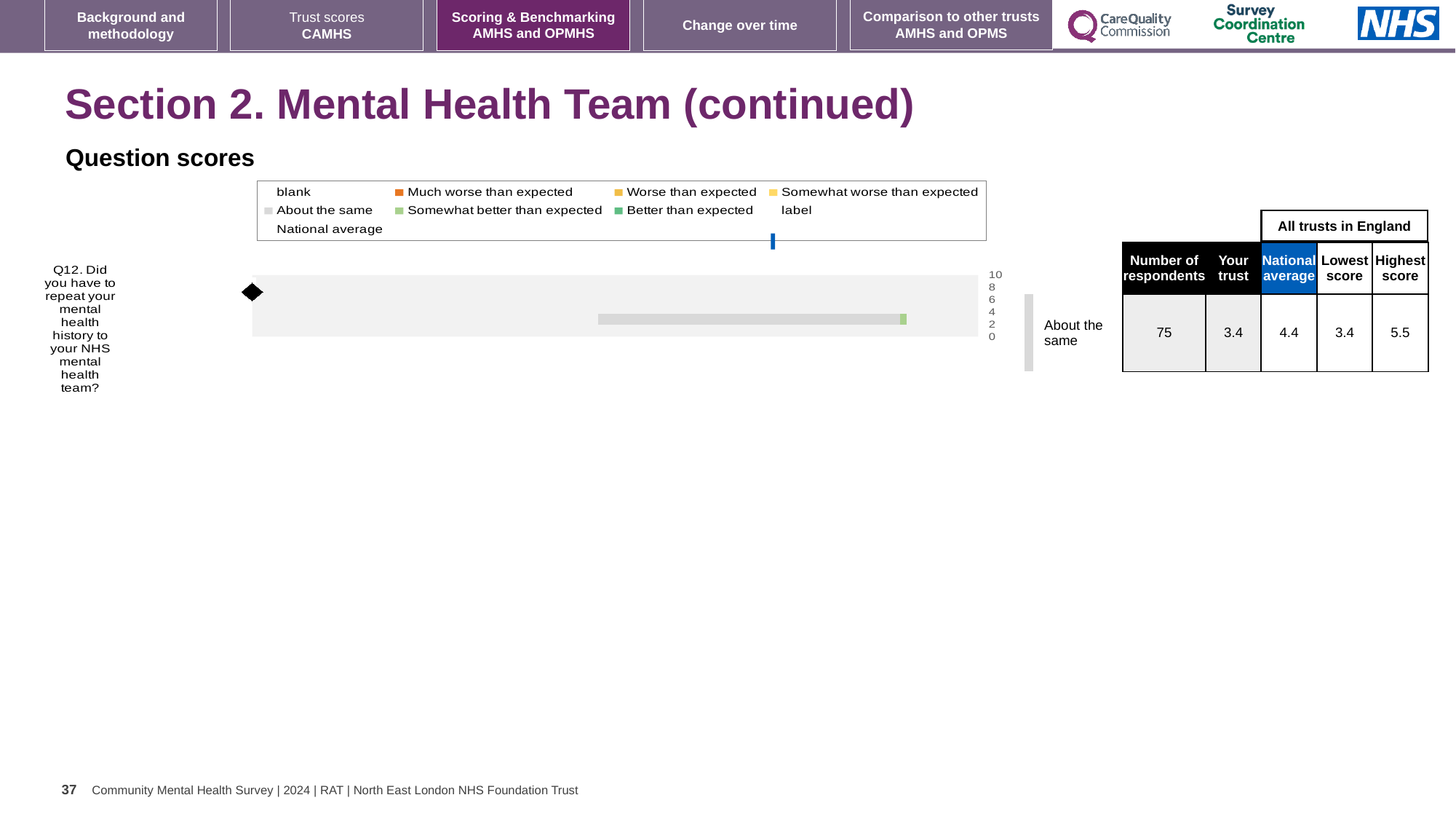
Which is larger for Q12, the 'Your trust' score or the national average? National average What is the number of respondents for Q12 (repeating mental health history)? 75 What is the highest score among all trusts in England for Q12? 5.5 What is the 'Your trust' score for Q12? 3.4 How many survey questions are plotted in the chart? 1 What benchmark category is shown next to the Q12 bar? About the same What is the heading above the chart? Question scores What is the difference between the highest score and the lowest score for Q12? 2.1 By how much does the national average exceed the 'Your trust' score for Q12? 1.0 What is the national average score for Q12? 4.4 What is the lowest score among all trusts in England for Q12? 3.4 What kind of chart is shown on the slide? bar chart